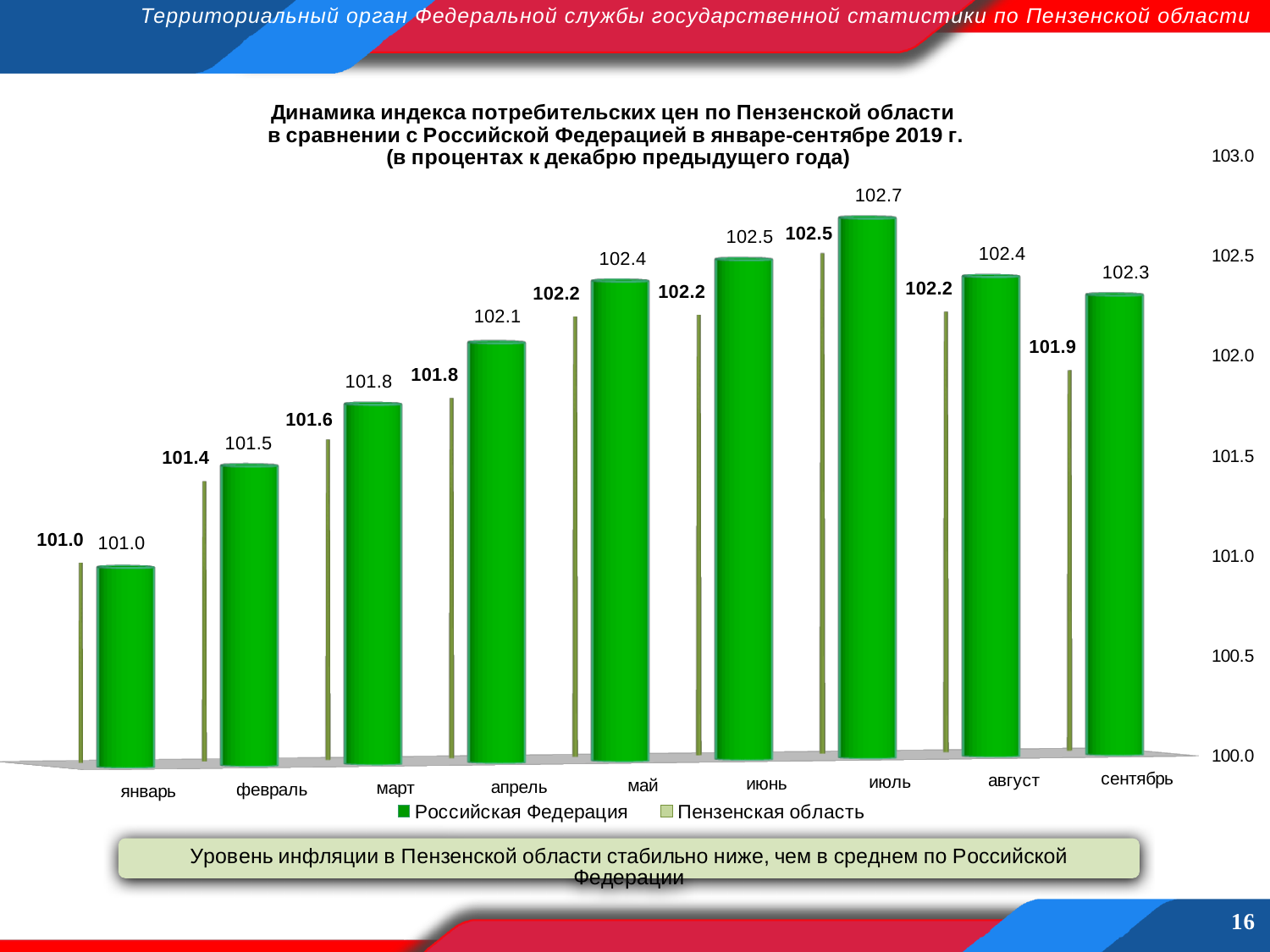
What is the value for Пензенская область in сентябрь? 101.9 What kind of chart is shown on the slide? bar chart What is the value for Пензенская область in июнь? 102.2 What is the value for Российская Федерация in июль? 102.7 Which is larger in май: Российская Федерация or Пензенская область? Российская Федерация What is the difference between Российская Федерация and Пензенская область in август? 0.2 How many months are shown on the x axis? 9 In which month is the value for Российская Федерация lowest? январь What is the value for Российская Федерация in апрель? 102.1 How many series does the legend list? 2 In which month is the value for Пензенская область highest? июль In which month is the value for Российская Федерация highest? июль